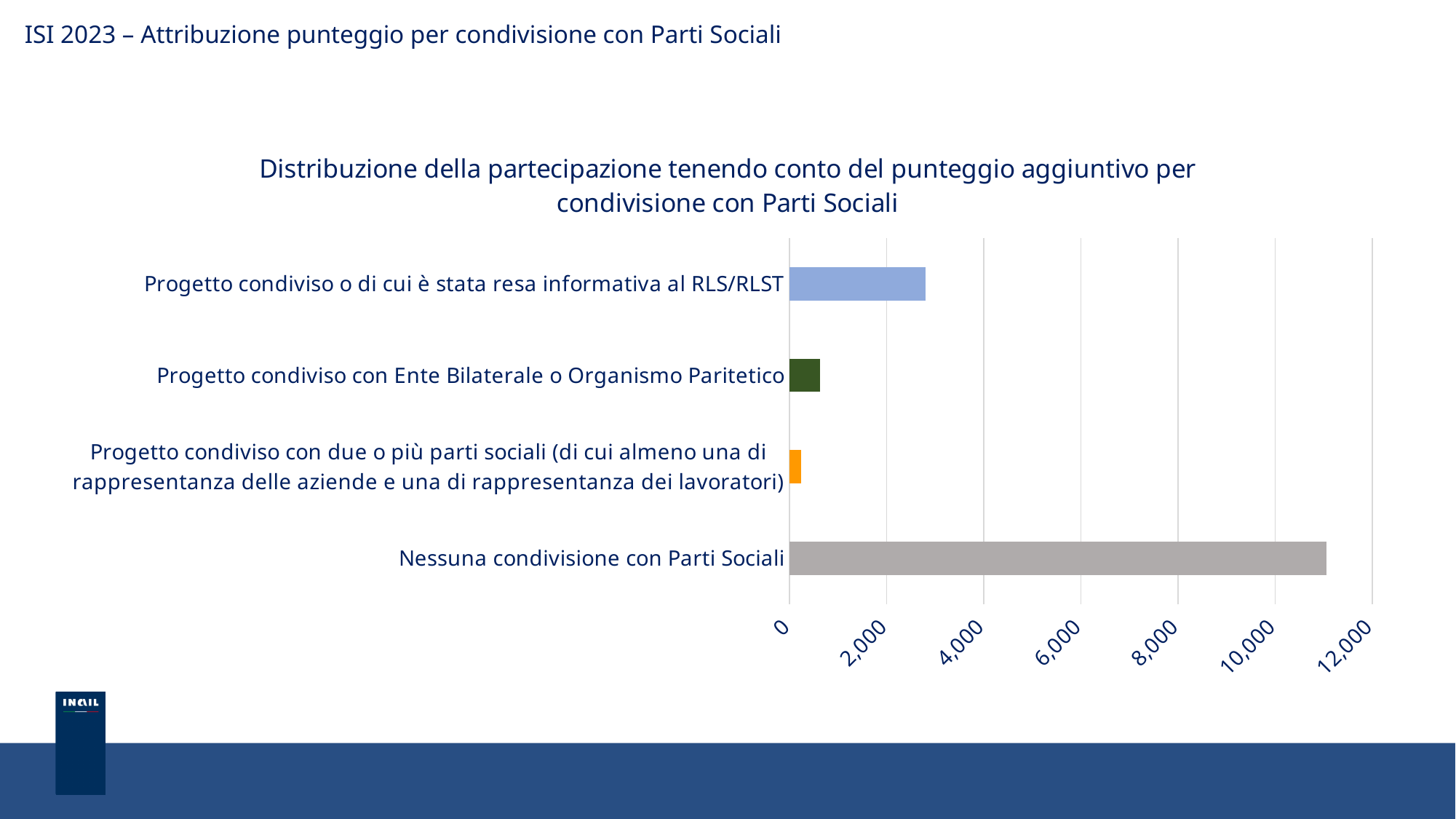
Which is larger: the value for 'Progetto condiviso con Ente Bilaterale o Organismo Paritetico' or the value for 'Progetto condiviso con due o più parti sociali'? Progetto condiviso con Ente Bilaterale o Organismo Paritetico Which is larger: the value for 'Progetto condiviso o di cui è stata resa informativa al RLS/RLST' or the value for 'Progetto condiviso con Ente Bilaterale o Organismo Paritetico'? Progetto condiviso o di cui è stata resa informativa al RLS/RLST What kind of chart is shown on the slide? bar chart What colour is the bar for 'Nessuna condivisione con Parti Sociali'? grey Is the value for 'Progetto condiviso o di cui è stata resa informativa al RLS/RLST' greater or less than 2,000? greater How many categories are plotted in the chart? 4 Is the value for 'Nessuna condivisione con Parti Sociali' greater or less than 12,000? less What is the maximum value shown on the horizontal axis? 12,000 Is the value for 'Nessuna condivisione con Parti Sociali' greater or less than 10,000? greater Which category has the highest value? Nessuna condivisione con Parti Sociali Which category has the lowest value? Progetto condiviso con due o più parti sociali (di cui almeno una di rappresentanza delle aziende e una di rappresentanza dei lavoratori)